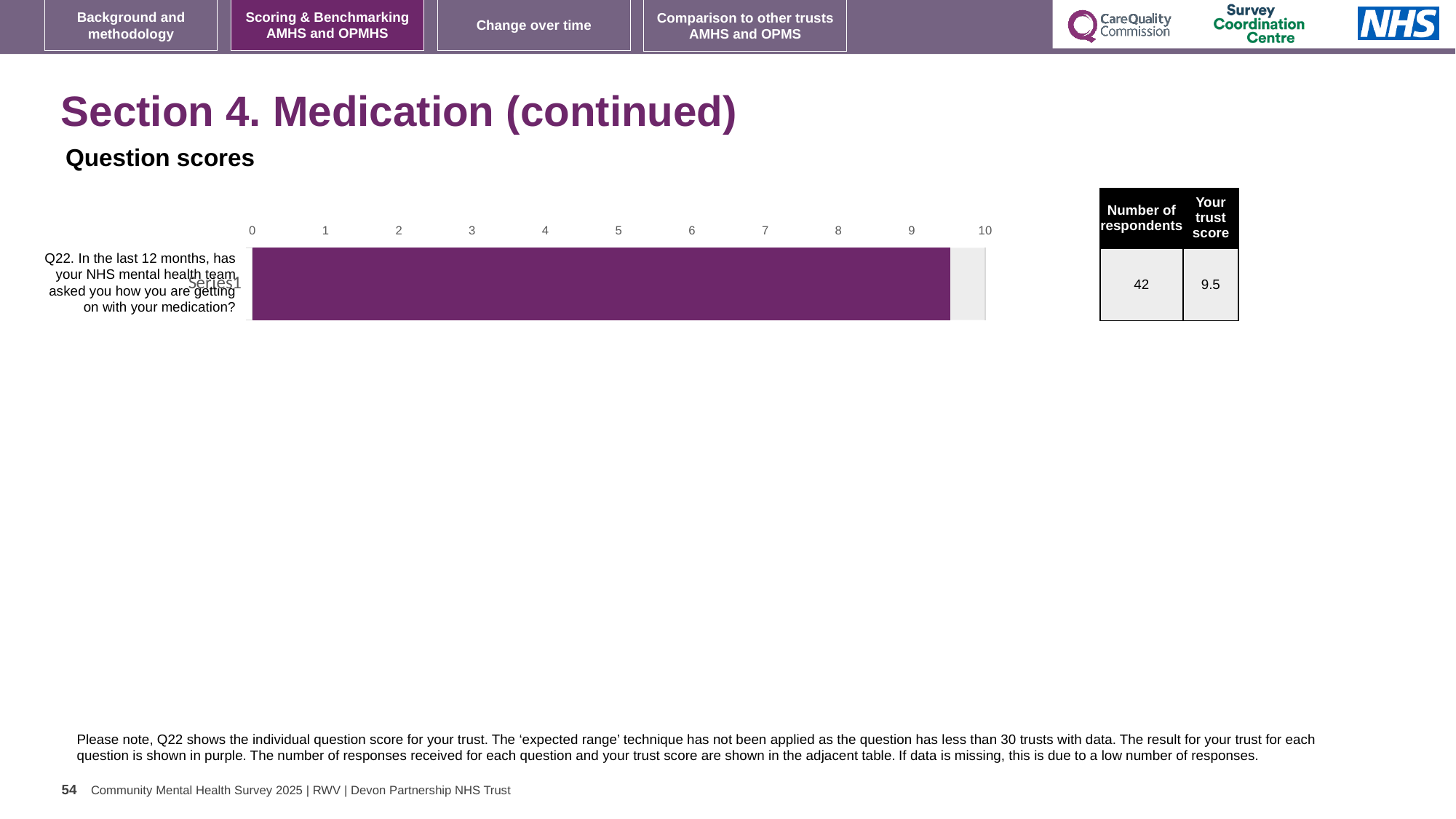
What kind of chart is shown on the slide? bar chart How many questions (bars) are plotted in the chart? 1 Is the value for Q22 greater or less than 9? greater What is the highest value shown on the chart's horizontal axis? 10 Is the value for Q22 greater or less than 8? greater According to the adjacent table, what is the trust score for Q22? 9.5 According to the adjacent table, how many respondents answered Q22? 42 What colour is the bar for Q22? purple Which question does the bar in the chart represent? Q22. In the last 12 months, has your NHS mental health team asked you how you are getting on with your medication? Is the value for Q22 greater or less than 10? less